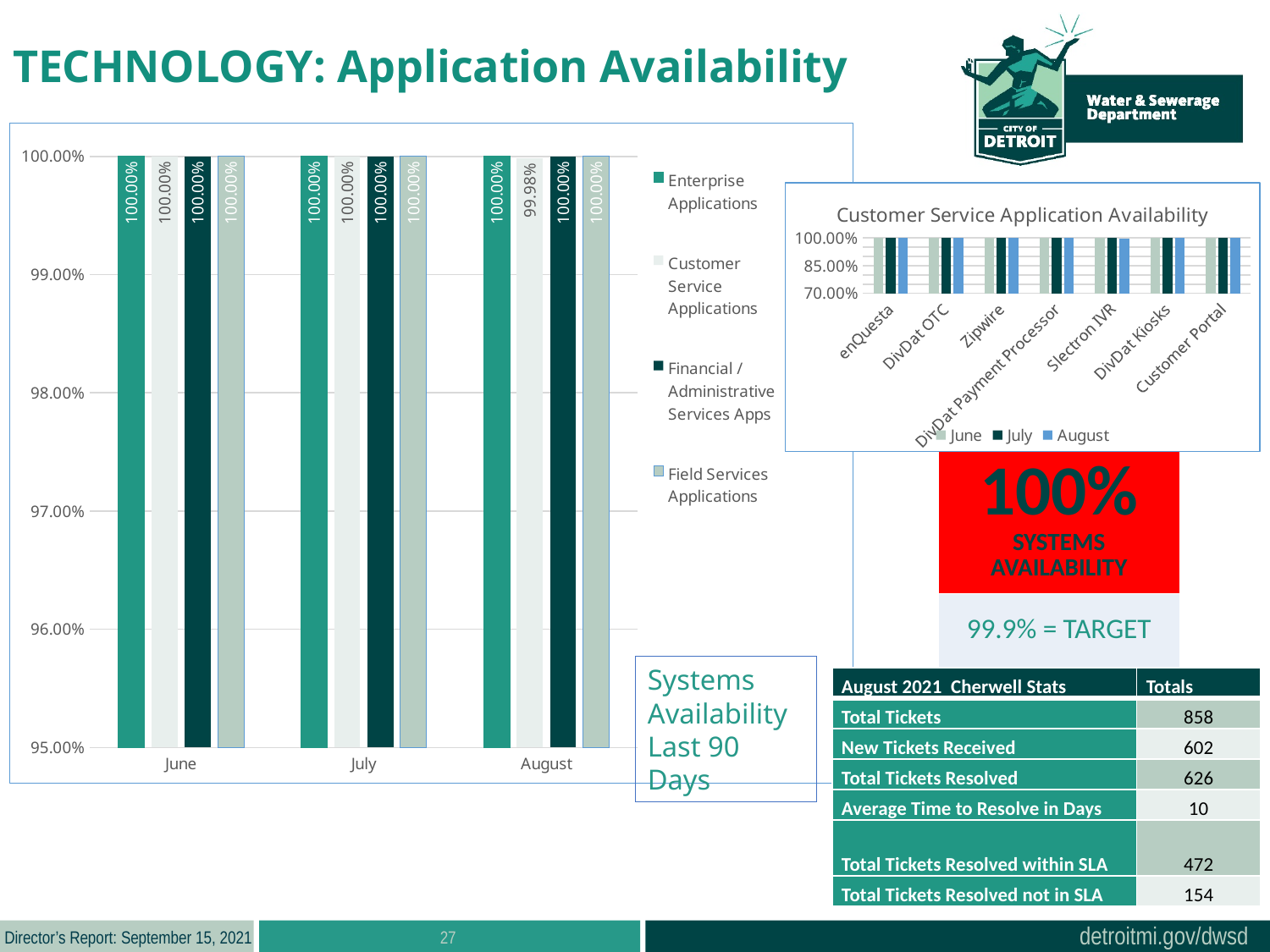
On the large bar chart on the left, what is the value for Customer Service Applications in August? 99.98% On the large bar chart on the left, what is the value for Enterprise Applications in June? 100.00% On the Customer Service Application Availability chart, how many series does the legend list? 3 What kind of chart is the large chart on the left? Bar chart On the large bar chart on the left, which series has the lowest value in August? Customer Service Applications On the large bar chart on the left, how many months are shown on the x axis? 3 On the large bar chart on the left, which is larger in August: Financial / Administrative Services Apps or Customer Service Applications? Financial / Administrative Services Apps On the Customer Service Application Availability chart, is the value for enQuesta in June greater or less than 85.00%? greater On the Customer Service Application Availability chart, how many applications are shown on the x axis? 7 On the large bar chart on the left, what is the value for Field Services Applications in July? 100.00% On the large bar chart on the left, how many series does the legend list? 4 On the large bar chart on the left, what is the difference between the Enterprise Applications value and the Customer Service Applications value in August? 0.02%